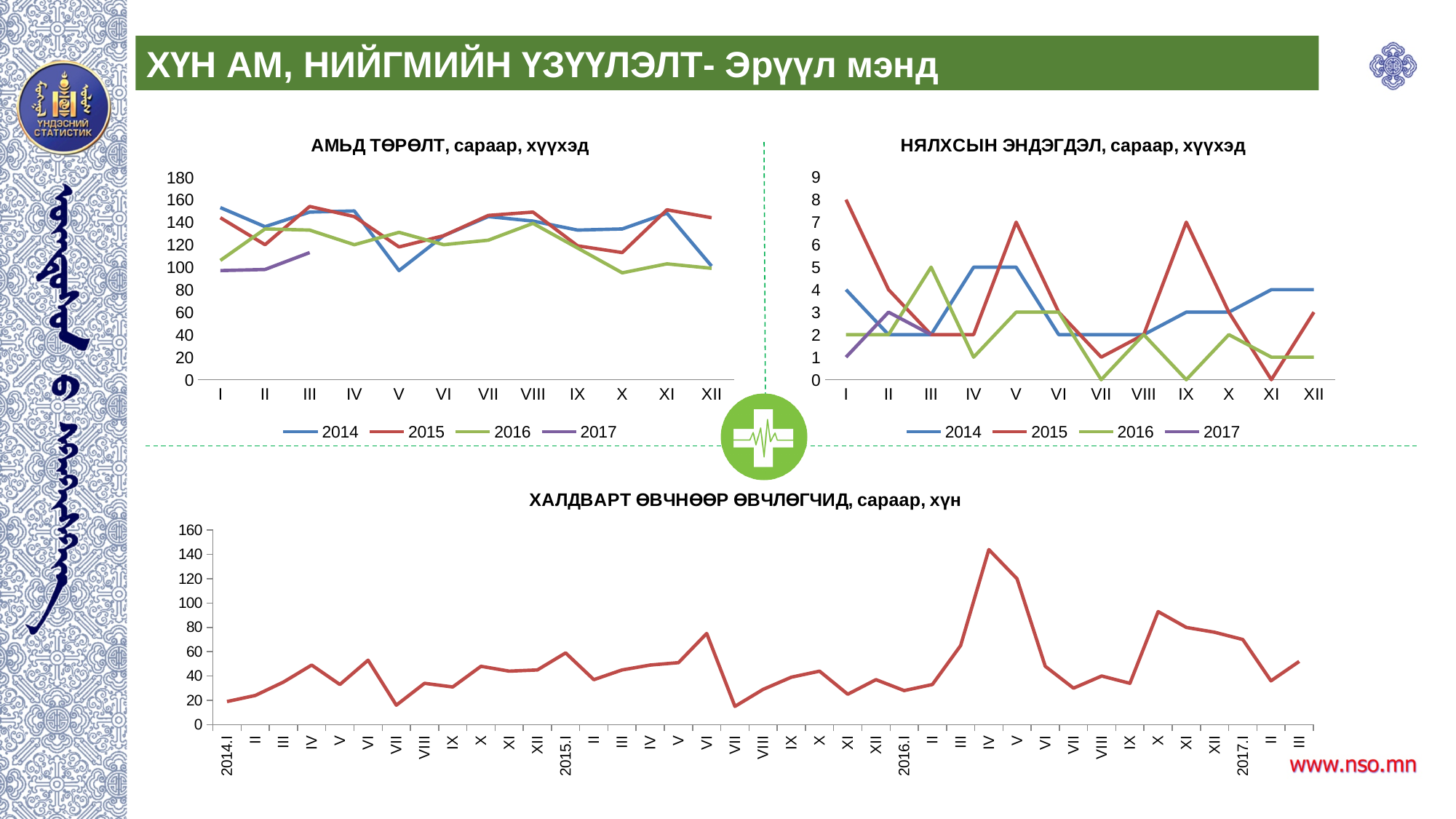
In the chart titled 'НЯЛХСЫН ЭНДЭГДЭЛ, сараар, хүүхэд', what is the value for 2017 in month II? 3 In the chart titled 'НЯЛХСЫН ЭНДЭГДЭЛ, сараар, хүүхэд', what is the difference between the 2015 and 2014 values in month I? 4 What kind of chart is the chart titled 'ХАЛДВАРТ ӨВЧНӨӨР ӨВЧЛӨГЧИД, сараар, хүн'? line chart How many series does the legend of the chart titled 'АМЬД ТӨРӨЛТ, сараар, хүүхэд' list? 4 In the chart titled 'НЯЛХСЫН ЭНДЭГДЭЛ, сараар, хүүхэд', in which month does the 2015 series reach its highest value? I In the chart titled 'АМЬД ТӨРӨЛТ, сараар, хүүхэд', is the value for 2017 in month I greater or less than 120? less In the chart titled 'ХАЛДВАРТ ӨВЧНӨӨР ӨВЧЛӨГЧИД, сараар, хүн', is the peak value at 2016.IV greater or less than 120? greater In the chart titled 'НЯЛХСЫН ЭНДЭГДЭЛ, сараар, хүүхэд', what is the value for 2016 in month III? 5 In the chart titled 'НЯЛХСЫН ЭНДЭГДЭЛ, сараар, хүүхэд', what is the value for 2015 in month I? 8 In the chart titled 'НЯЛХСЫН ЭНДЭГДЭЛ, сараар, хүүхэд', which is larger in month V: the 2015 value or the 2016 value? 2015 In the chart titled 'АМЬД ТӨРӨЛТ, сараар, хүүхэд', is the value for 2015 in month III greater or less than 140? greater In the chart titled 'НЯЛХСЫН ЭНДЭГДЭЛ, сараар, хүүхэд', what is the value for 2015 in month XI? 0